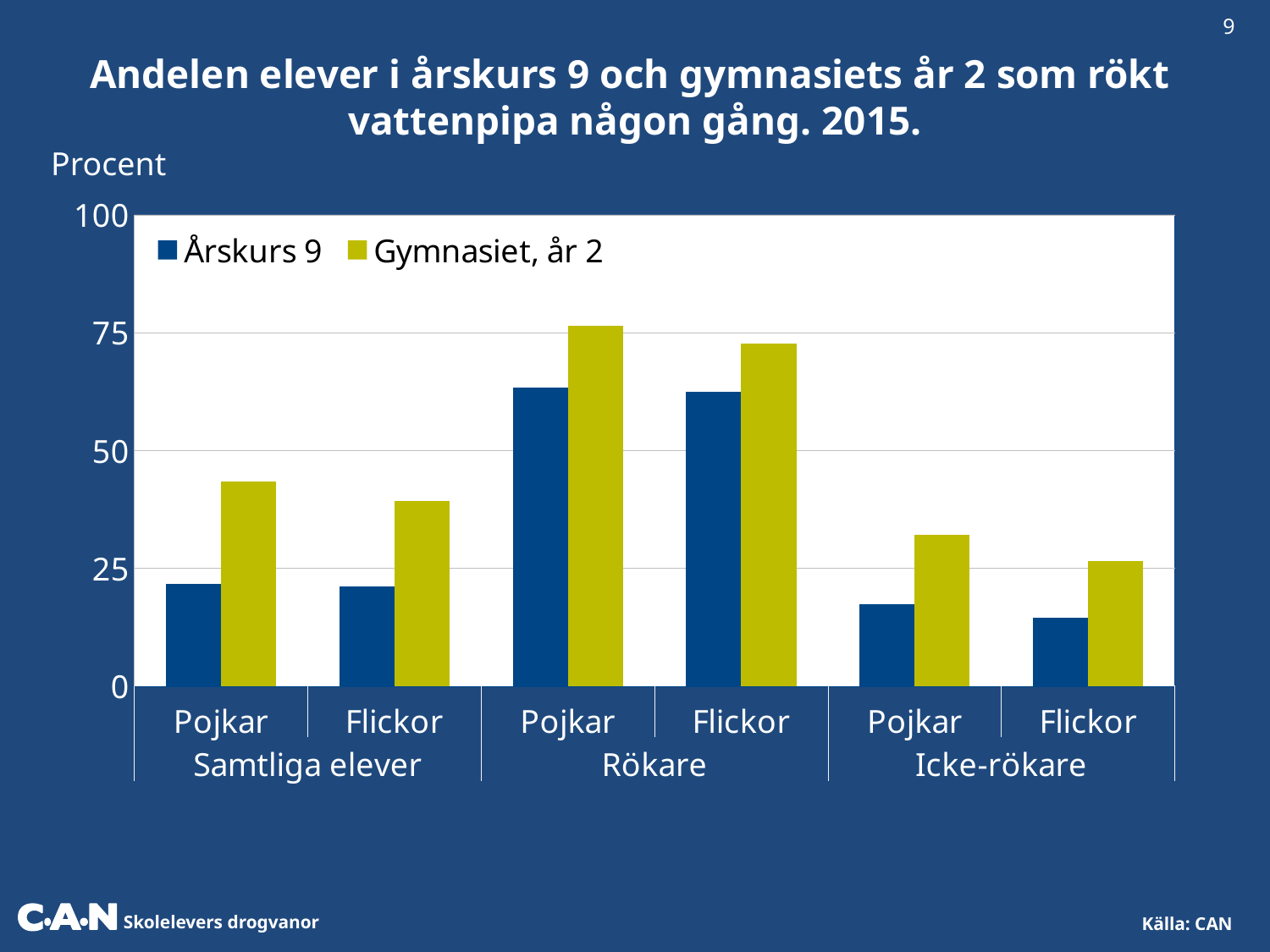
How many series does the legend list? 2 How many groups of bars are plotted along the x axis? 6 For Pojkar among Rökare, which series has the larger value: Årskurs 9 or Gymnasiet, år 2? Gymnasiet, år 2 What are the two series named in the legend? Årskurs 9 and Gymnasiet, år 2 Is the Årskurs 9 value for Flickor among Rökare greater or less than 50? greater What kind of chart is shown on the slide? Bar chart Which group has the lowest Årskurs 9 bar? Flickor, Icke-rökare Which is larger: the Gymnasiet, år 2 value for Flickor among Samtliga elever or the Gymnasiet, år 2 value for Pojkar among Icke-rökare? Flickor among Samtliga elever Is the Gymnasiet, år 2 value for Pojkar among Rökare greater or less than 50? greater Is the Gymnasiet, år 2 value for Flickor among Icke-rökare greater or less than 50? less Which group has the highest Gymnasiet, år 2 bar? Pojkar, Rökare